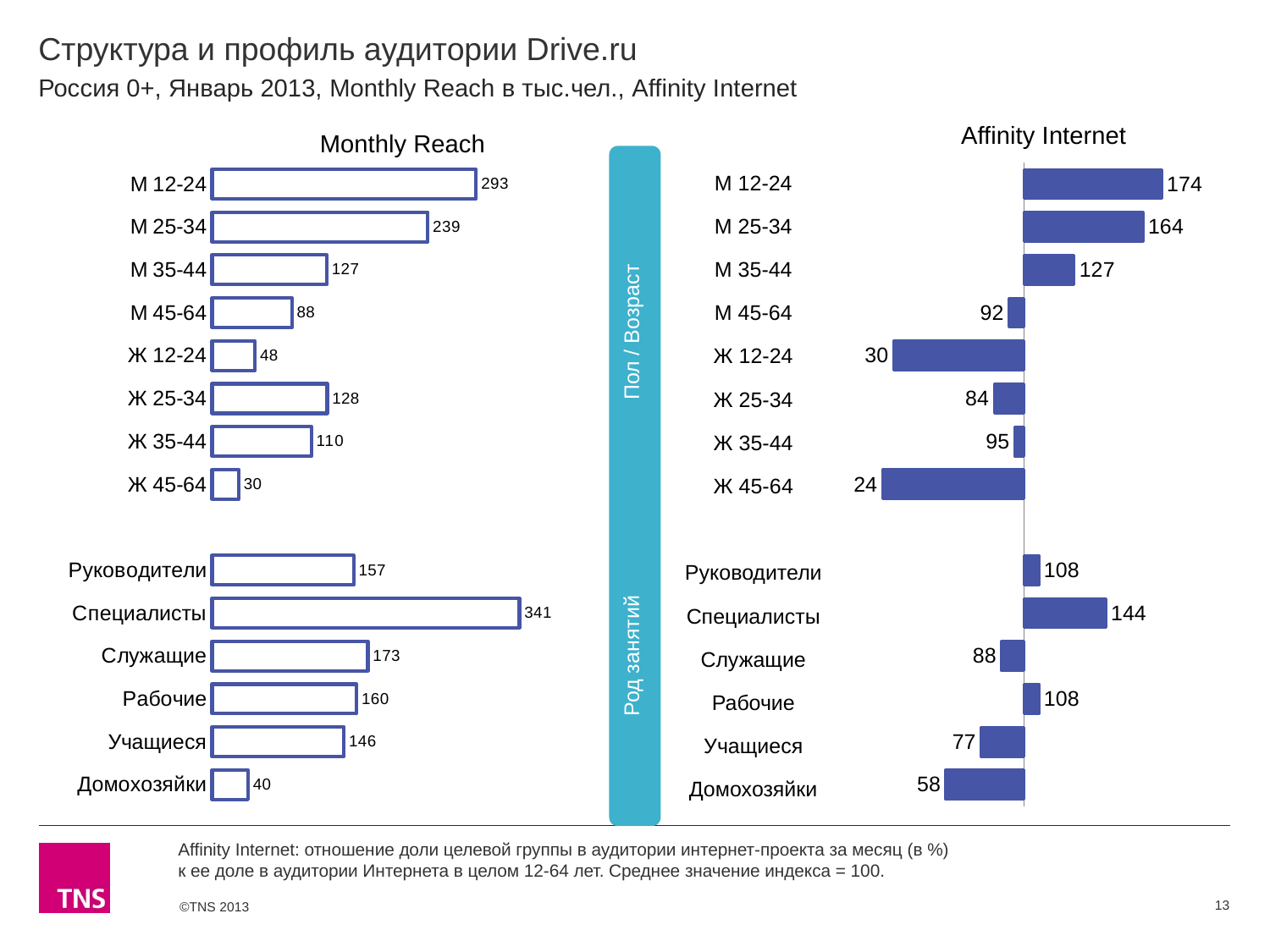
In the Affinity Internet chart, what is the value for Ж 12-24? 30 In the Affinity Internet chart, which category has the lowest value? Ж 45-64 In the Monthly Reach chart, what is the difference between М 12-24 and М 25-34? 54 In the Monthly Reach chart, what is the value for М 12-24? 293 In the Affinity Internet chart, which is larger, М 35-44 or Руководители? М 35-44 In the Monthly Reach chart, how many categories are plotted? 14 In the Monthly Reach chart, what is the difference between Служащие and Рабочие? 13 In the Monthly Reach chart, which category has the lowest value among the gender/age groups? Ж 45-64 In the Affinity Internet chart, what is the value for Специалисты? 144 What is the title of the chart on the right side of the slide? Affinity Internet What kind of chart is the Affinity Internet chart? bar chart In the Monthly Reach chart, which category has the highest value? Специалисты